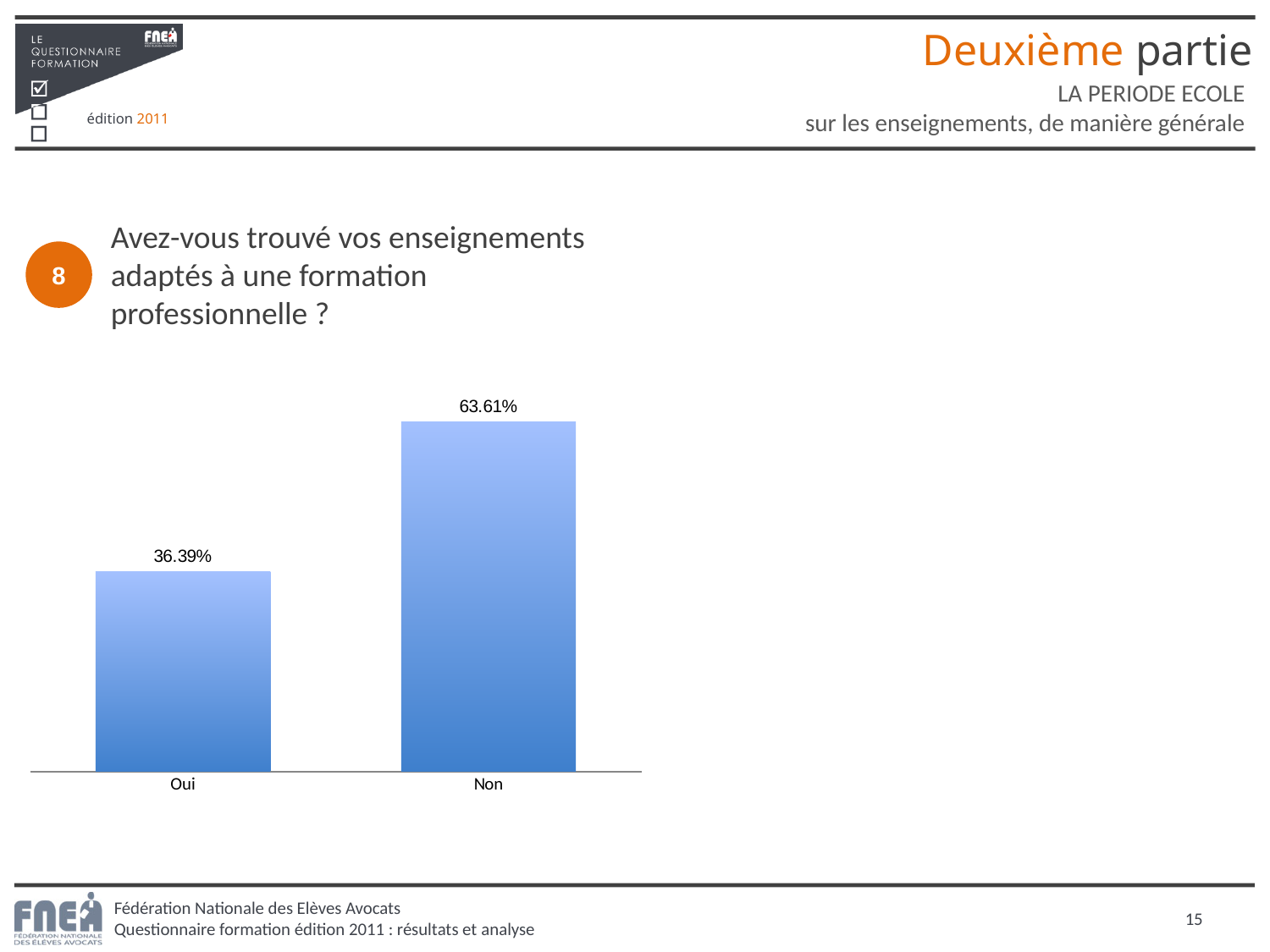
Which category has the highest value? Non What is the total of the two values shown in the chart? 100% What is the difference between the values for Non and Oui? 27.22% How many categories are shown in the chart? 2 What kind of chart is shown on the slide? bar chart What question does the chart answer? Avez-vous trouvé vos enseignements adaptés à une formation professionnelle ? What is the value for Oui? 36.39% What are the category labels on the x axis? Oui, Non Which category has the lowest value? Oui What is the value for Non? 63.61% Which is larger, the value for Oui or the value for Non? Non